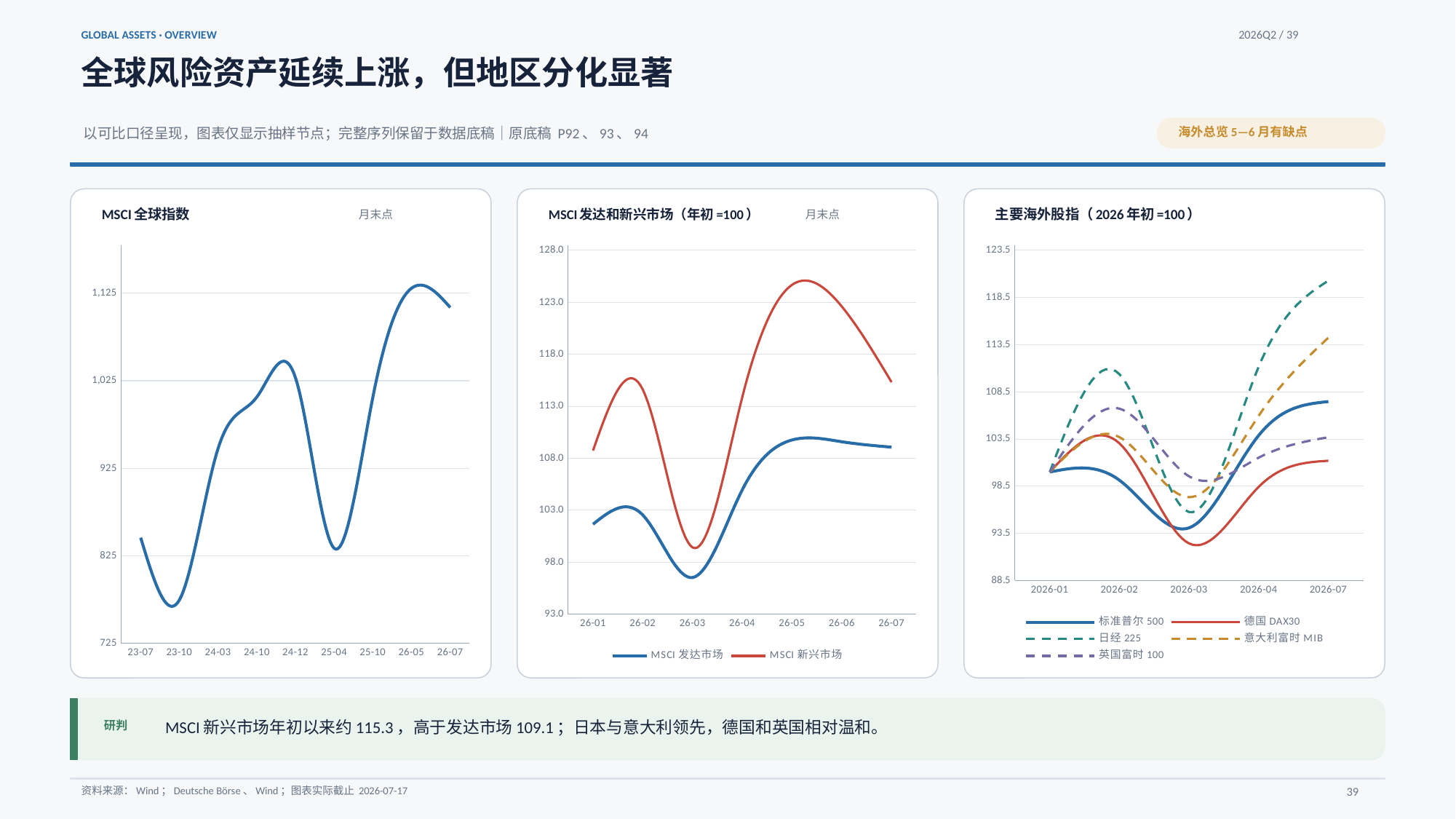
In the 'MSCI 发达和新兴市场（年初=100）' chart, is the value for MSCI 新兴市场 at 26-05 greater or less than 118.0? greater In the 'MSCI 全球指数' chart, how many x-axis labels are shown? 9 In the 'MSCI 发达和新兴市场（年初=100）' chart, which series is higher at 26-07, MSCI 发达市场 or MSCI 新兴市场? MSCI 新兴市场 In the 'MSCI 发达和新兴市场（年初=100）' chart, how many series does the legend list? 2 What kind of chart is the 'MSCI 全球指数' chart on the left? line chart In the 'MSCI 全球指数' chart, does the index overall rise or fall from 23-07 to 26-07? rise In the '主要海外股指（2026年初=100）' chart, which series is lowest at 2026-03? 德国 DAX30 In the 'MSCI 发达和新兴市场（年初=100）' chart, is the value for MSCI 发达市场 at 26-03 greater or less than 98.0? less In the '主要海外股指（2026年初=100）' chart, is the value for 德国 DAX30 at 2026-07 greater or less than 103.5? less In the '主要海外股指（2026年初=100）' chart, which series is highest at 2026-07? 日经 225 In the '主要海外股指（2026年初=100）' chart, how many series does the legend list? 5